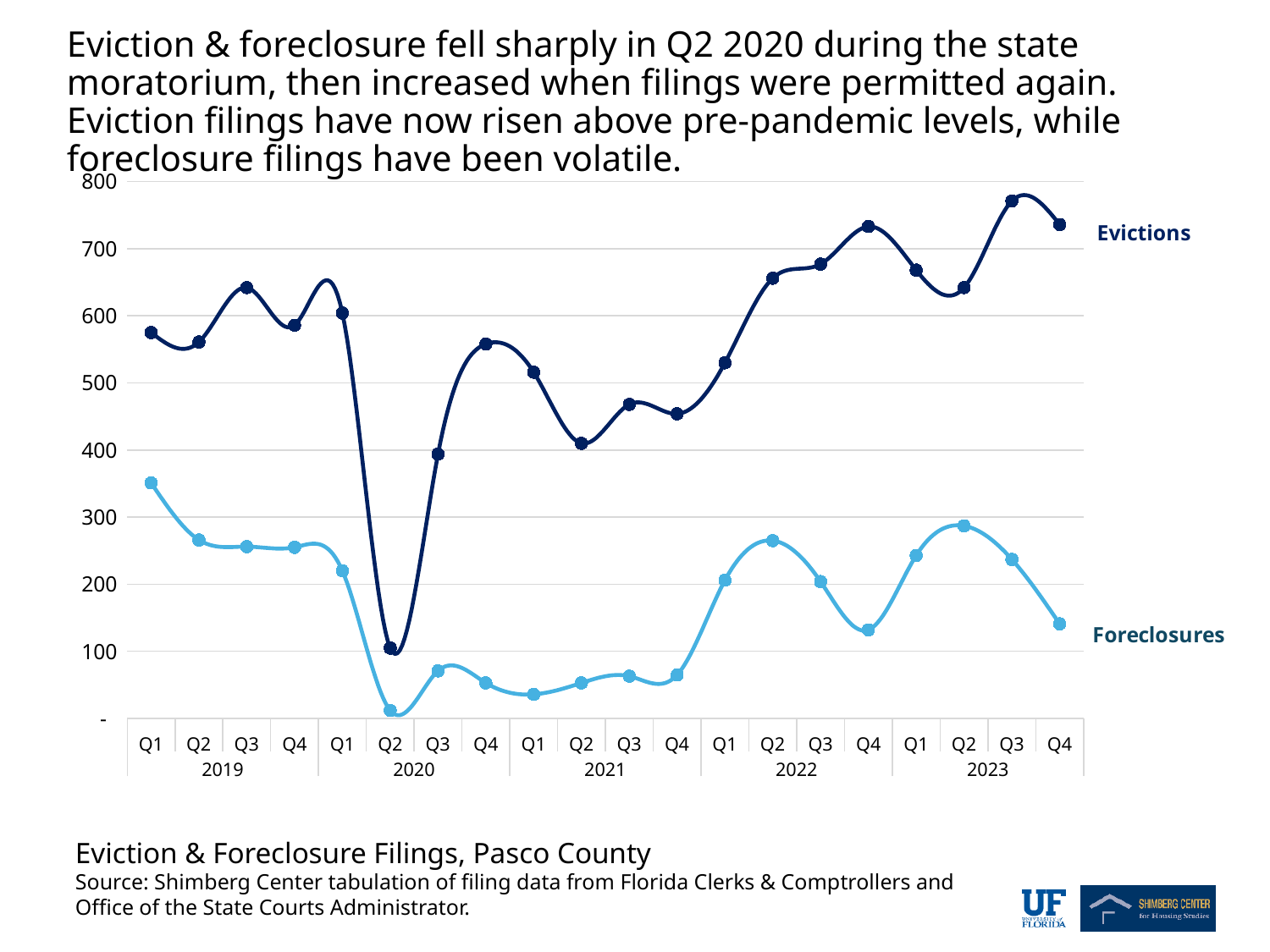
How many series are plotted on the chart? 2 In which quarter is the Foreclosures series at its lowest? Q2 2020 In which quarter is the Evictions series at its lowest? Q2 2020 In which quarter is the Foreclosures series at its highest? Q1 2019 Is the Evictions value for Q2 2020 greater or less than 200? less Is the Foreclosures value for Q1 2019 greater or less than 300? greater Which is larger for Foreclosures: the value in Q2 2022 or the value in Q4 2022? Q2 2022 How many quarterly data points does each series have? 20 In which quarter is the Evictions series at its highest? Q3 2023 What kind of chart is shown on the slide? line chart Do Evictions rise or fall from Q1 2022 to Q4 2022? rise Is the Evictions value for Q3 2023 greater or less than 700? greater